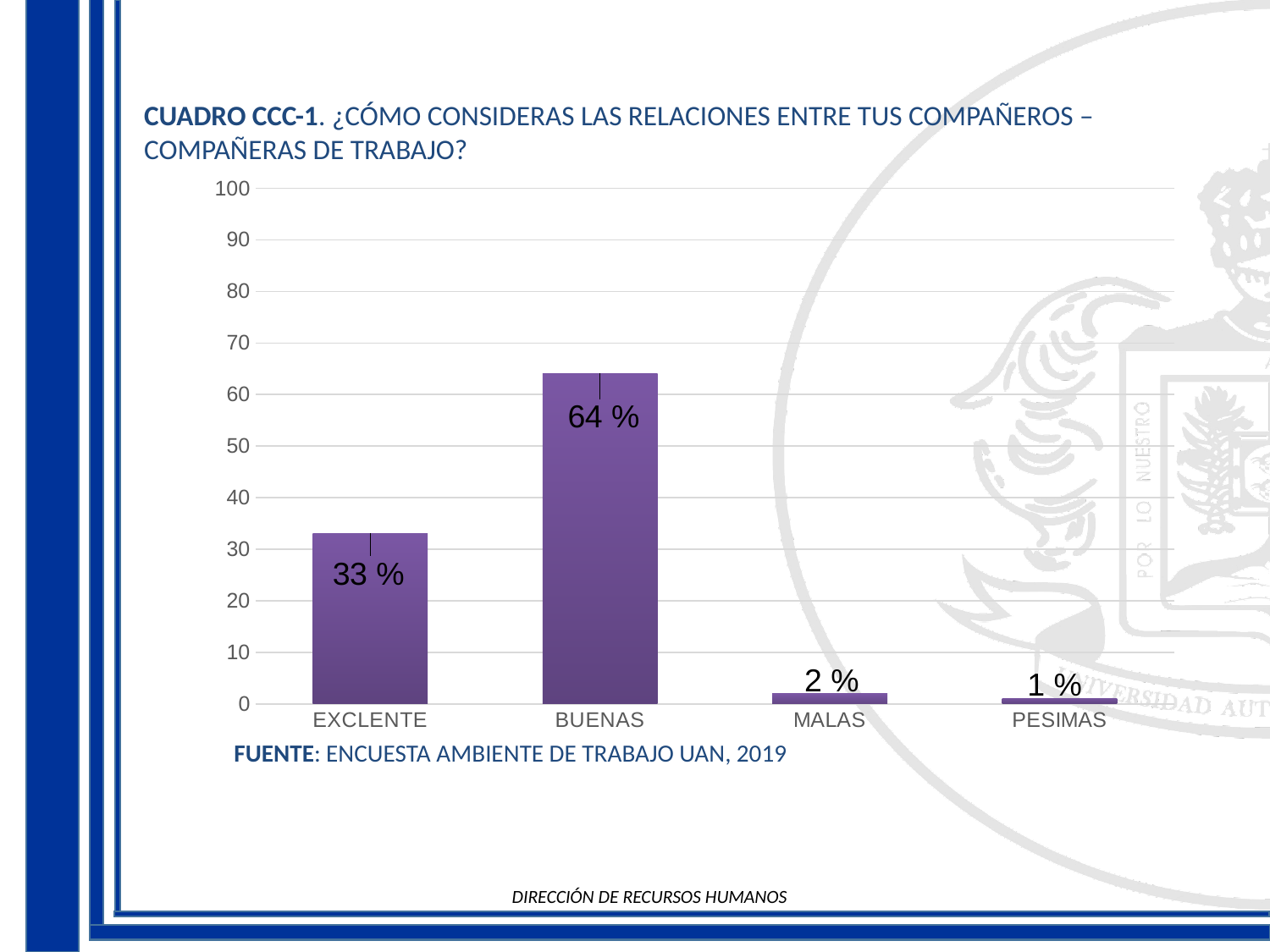
Which category has the highest value? BUENAS Which category has the lowest value? PESIMAS What is the value for PESIMAS? 1 % What is the value for MALAS? 2 % What is the difference between the values for BUENAS and EXCLENTE? 31 % What is the value for BUENAS? 64 % What source is cited below the chart? ENCUESTA AMBIENTE DE TRABAJO UAN, 2019 How many categories are shown on the x axis? 4 What kind of chart is shown on the slide? bar chart Which is larger, the value for EXCLENTE or the value for MALAS? EXCLENTE Is the value for BUENAS greater or less than 60? greater What is the value for EXCLENTE? 33 %